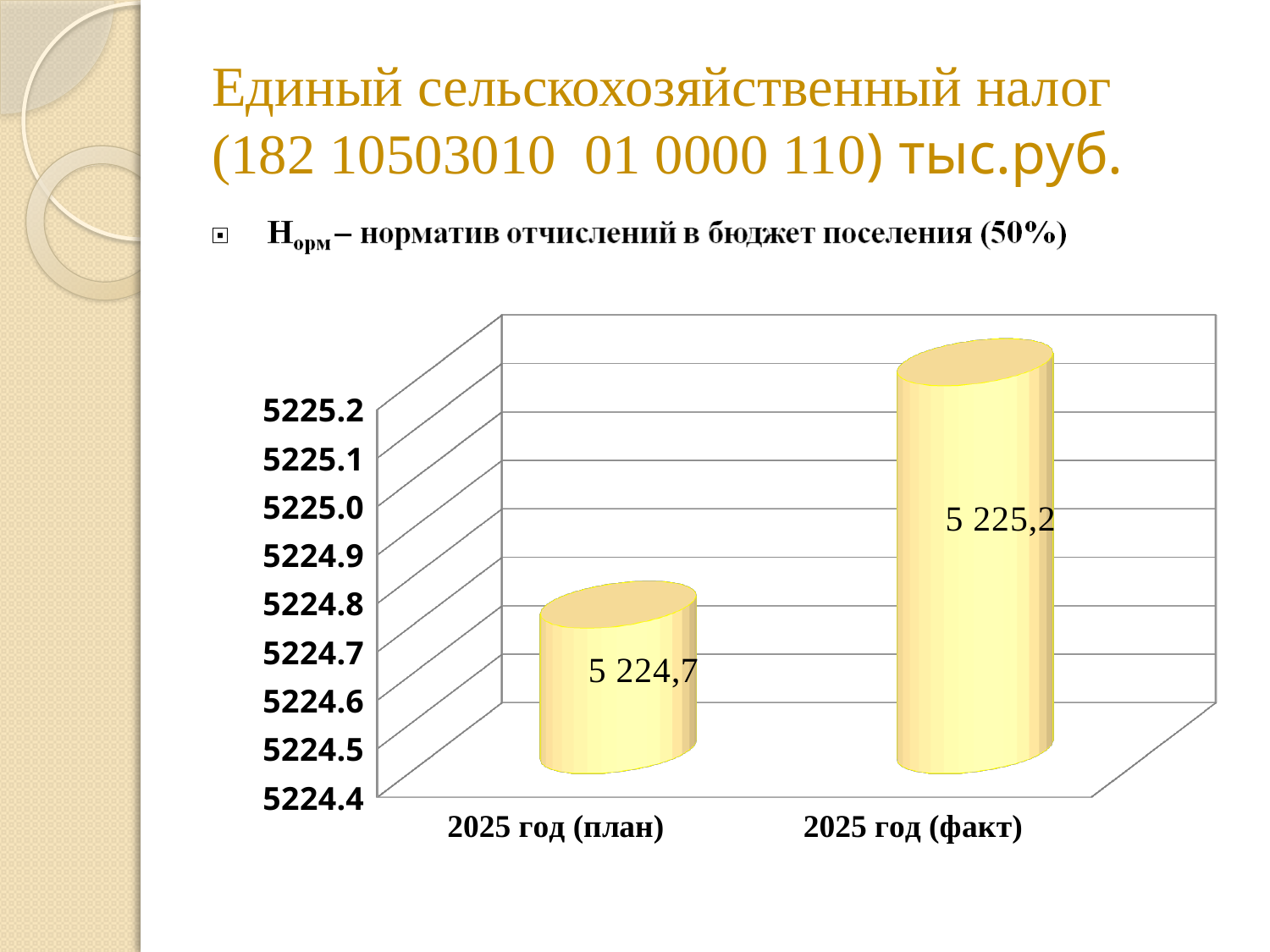
Which category has the lowest value? 2025 год (план) What is the difference between the values for 2025 год (факт) and 2025 год (план)? 0,5 How many categories are shown on the x axis of the chart? 2 What is the lowest value shown on the vertical axis of the chart? 5224.4 Is the value for 2025 год (план) greater or less than 5225.0? less Do the values rise or fall from 2025 год (план) to 2025 год (факт)? rise What kind of chart is shown on the slide? bar chart Which category has the highest value? 2025 год (факт) What is the value for 2025 год (факт)? 5 225,2 What is the value for 2025 год (план)? 5 224,7 Which is larger, the value for 2025 год (план) or the value for 2025 год (факт)? 2025 год (факт) Is the value for 2025 год (факт) greater or less than 5225.0? greater